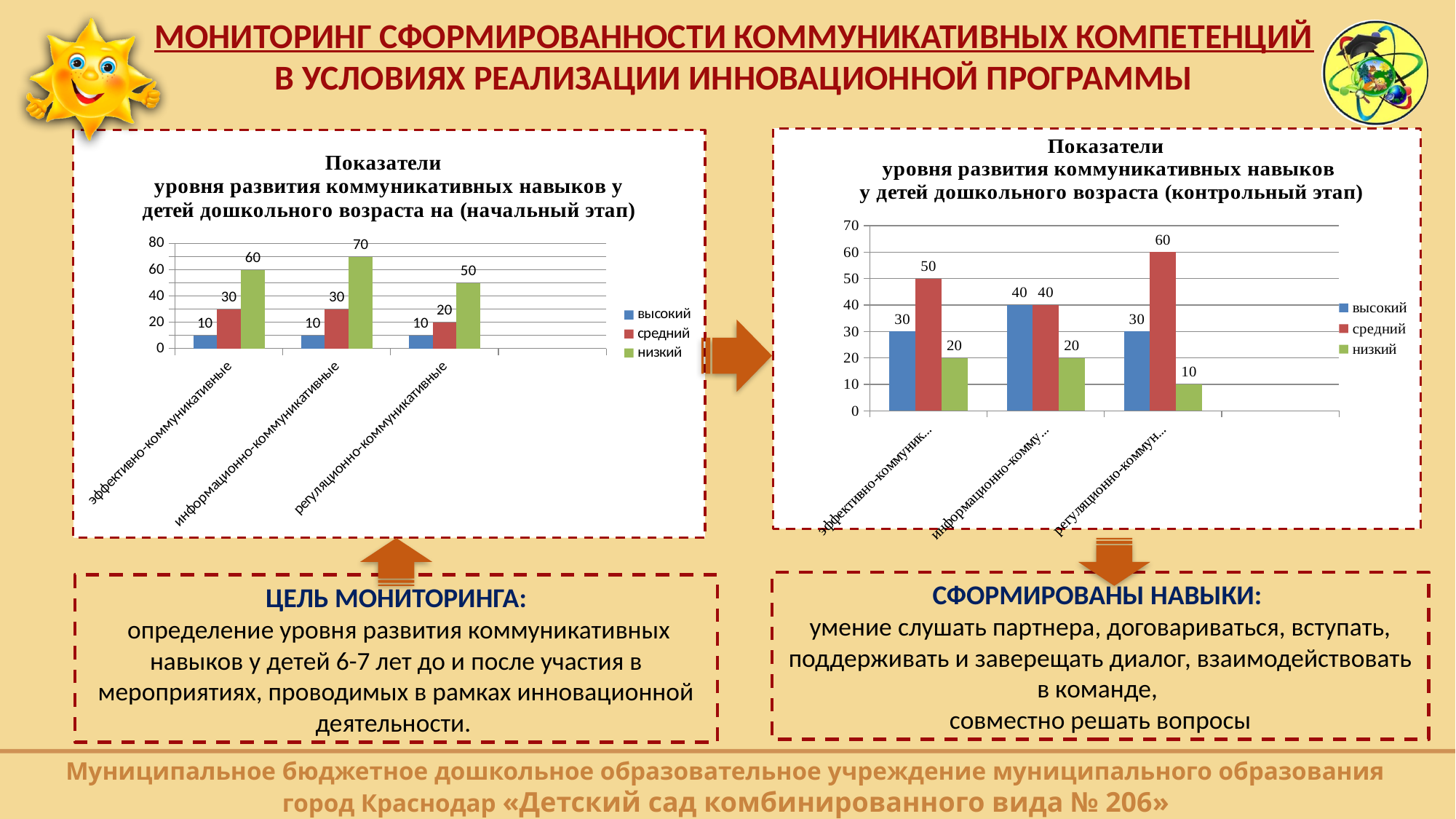
In the right chart (контрольный этап), what is the value of высокий for информационно-коммуникативные? 40 In the left chart (начальный этап), which category has the highest низкий value? информационно-коммуникативные In the left chart (начальный этап), what colour represents the series низкий? green What type of chart is the right chart (контрольный этап)? bar chart In the right chart (контрольный этап), which category has the lowest низкий value? регуляционно-коммуникативные In the left chart (начальный этап), which is larger for эффективно-коммуникативные: средний or низкий? низкий In the right chart (контрольный этап), what is the value of средний for регуляционно-коммуникативные? 60 How many categories are shown on the x axis of the left chart (начальный этап)? 3 How many series does the legend of the right chart (контрольный этап) list? 3 In the right chart (контрольный этап), what is the difference between средний and низкий for эффективно-коммуникативные? 30 In the left chart (начальный этап), what is the value of средний for регуляционно-коммуникативные? 20 In the left chart (начальный этап), what is the value of низкий for информационно-коммуникативные? 70